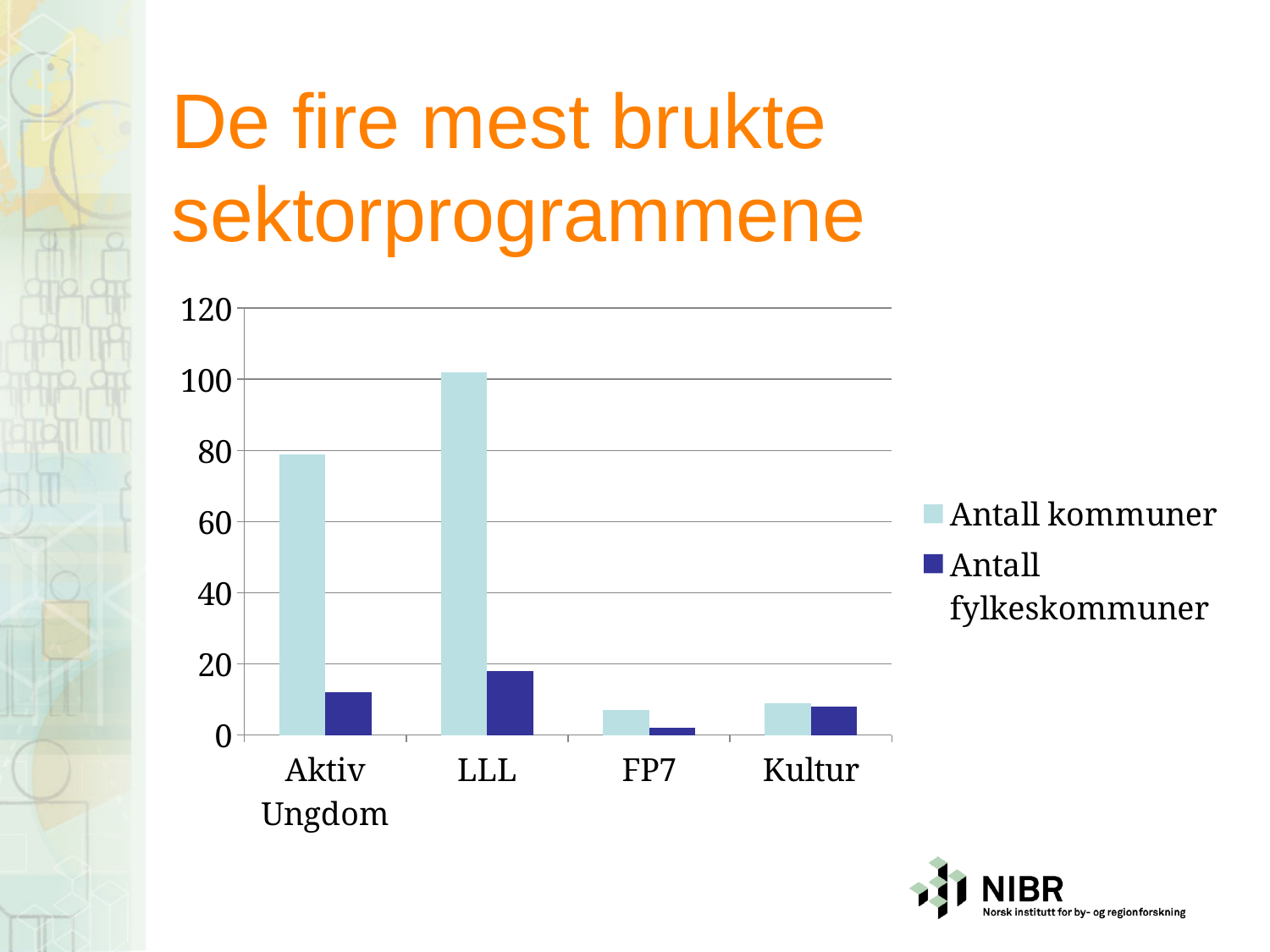
How many series does the legend list? 2 How many categories are shown on the x axis? 4 Is the value for Antall fylkeskommuner for LLL greater or less than 20? less Which category has the highest value for Antall kommuner? LLL Is the value for Antall kommuner for LLL greater or less than 100? greater What is the title of the slide? De fire mest brukte sektorprogrammene Which category has the highest value for Antall fylkeskommuner? LLL Which category has the lowest value for Antall fylkeskommuner? FP7 Which is larger for Aktiv Ungdom: Antall kommuner or Antall fylkeskommuner? Antall kommuner What kind of chart is shown on the slide? bar chart Which category has the lowest value for Antall kommuner? FP7